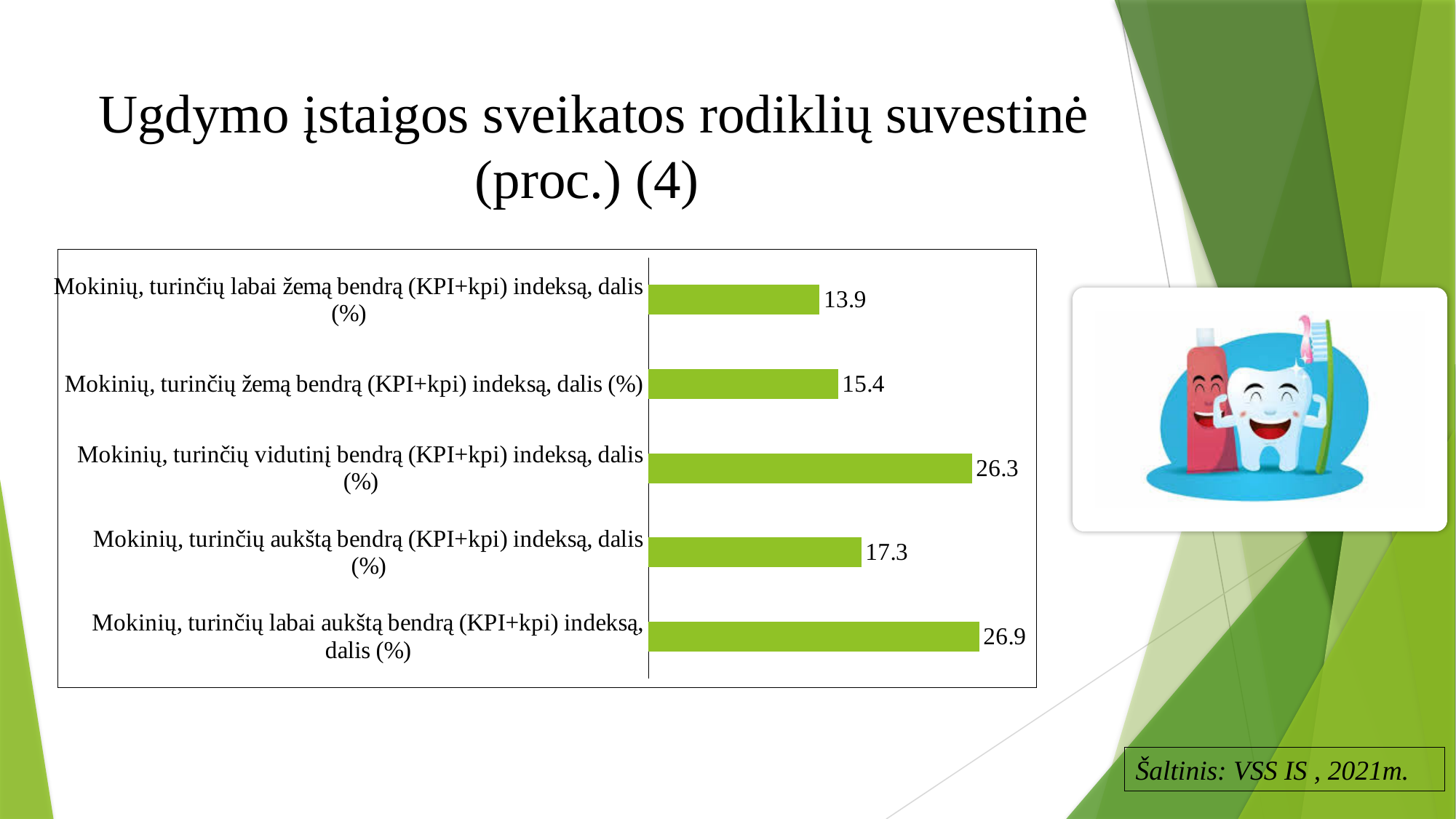
Which category has the lowest value? Mokinių, turinčių labai žemą bendrą (KPI+kpi) indeksą, dalis (%) What is the value for 'Mokinių, turinčių labai aukštą bendrą (KPI+kpi) indeksą, dalis (%)'? 26.9 What is the value for 'Mokinių, turinčių žemą bendrą (KPI+kpi) indeksą, dalis (%)'? 15.4 What is the value for 'Mokinių, turinčių aukštą bendrą (KPI+kpi) indeksą, dalis (%)'? 17.3 What kind of chart is shown on the slide? Bar chart What is the difference between the values for 'labai aukštą' and 'labai žemą' bendrą (KPI+kpi) indeksą? 13 What is the difference between the values for 'vidutinį' and 'aukštą' bendrą (KPI+kpi) indeksą? 9 What is the value for 'Mokinių, turinčių labai žemą bendrą (KPI+kpi) indeksą, dalis (%)'? 13.9 What is the value for 'Mokinių, turinčių vidutinį bendrą (KPI+kpi) indeksą, dalis (%)'? 26.3 Which category has the highest value? Mokinių, turinčių labai aukštą bendrą (KPI+kpi) indeksą, dalis (%) Which is larger: the value for 'aukštą' or 'žemą' bendrą (KPI+kpi) indeksą? Mokinių, turinčių aukštą bendrą (KPI+kpi) indeksą, dalis (%) How many categories are shown in the chart? 5